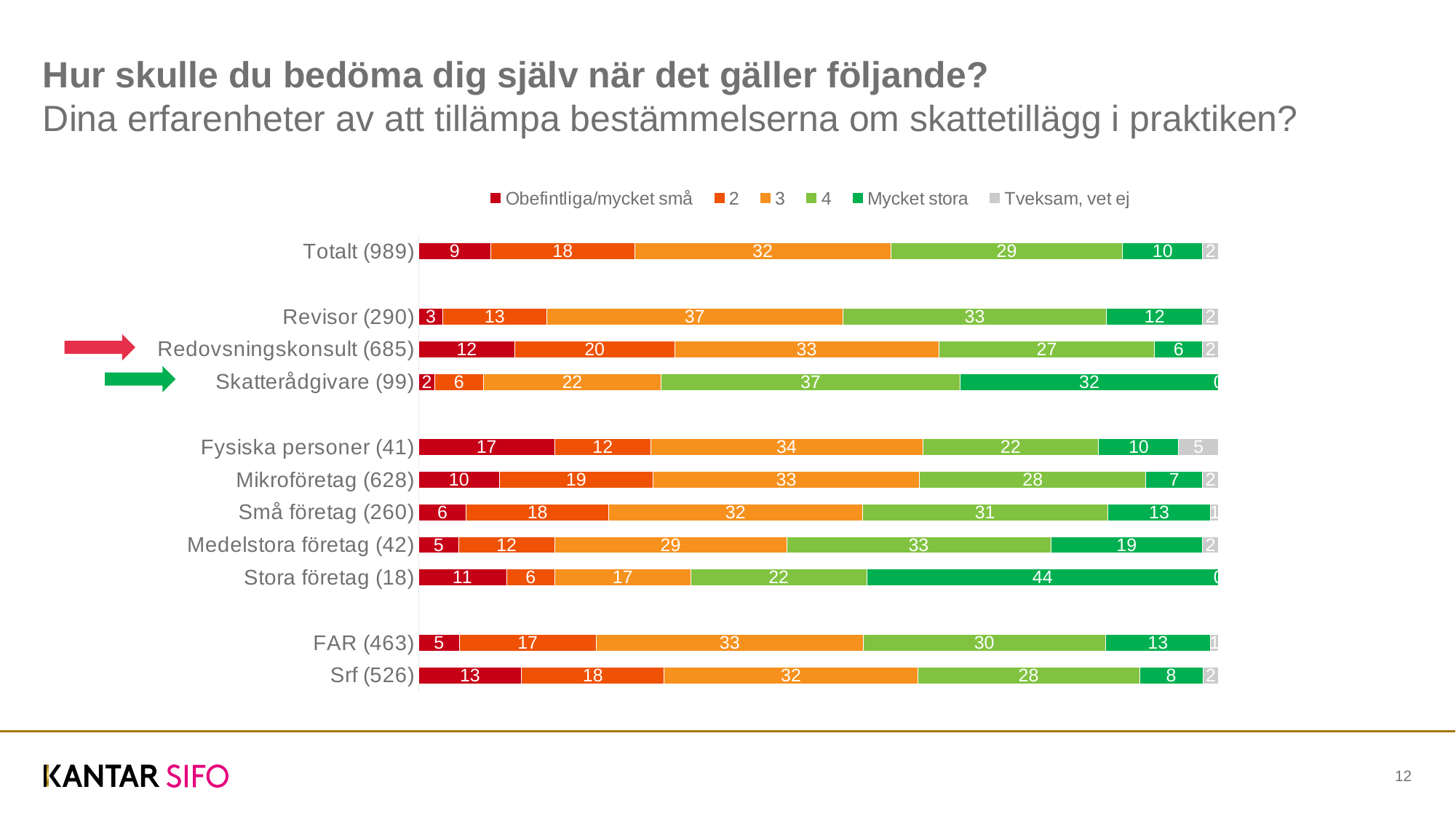
How many series does the legend list? 6 What is the "Mycket stora" value for Skatterådgivare (99)? 32 What is the first entry in the chart legend? Obefintliga/mycket små Which category has the highest "Mycket stora" value? Stora företag (18) Which category has the lowest "Obefintliga/mycket små" value? Skatterådgivare (99) What is the difference between the "4" values for Skatterådgivare (99) and Redovsningskonsult (685)? 10 What is the "Obefintliga/mycket små" value for Fysiska personer (41)? 17 Which has a larger "2" value, Revisor (290) or Redovsningskonsult (685)? Redovsningskonsult (685) What is the "Tveksam, vet ej" value for Fysiska personer (41)? 5 How many categories are shown on the chart? 11 What is the value for "3" for Totalt (989)? 32 What kind of chart is shown on the slide? Stacked bar chart